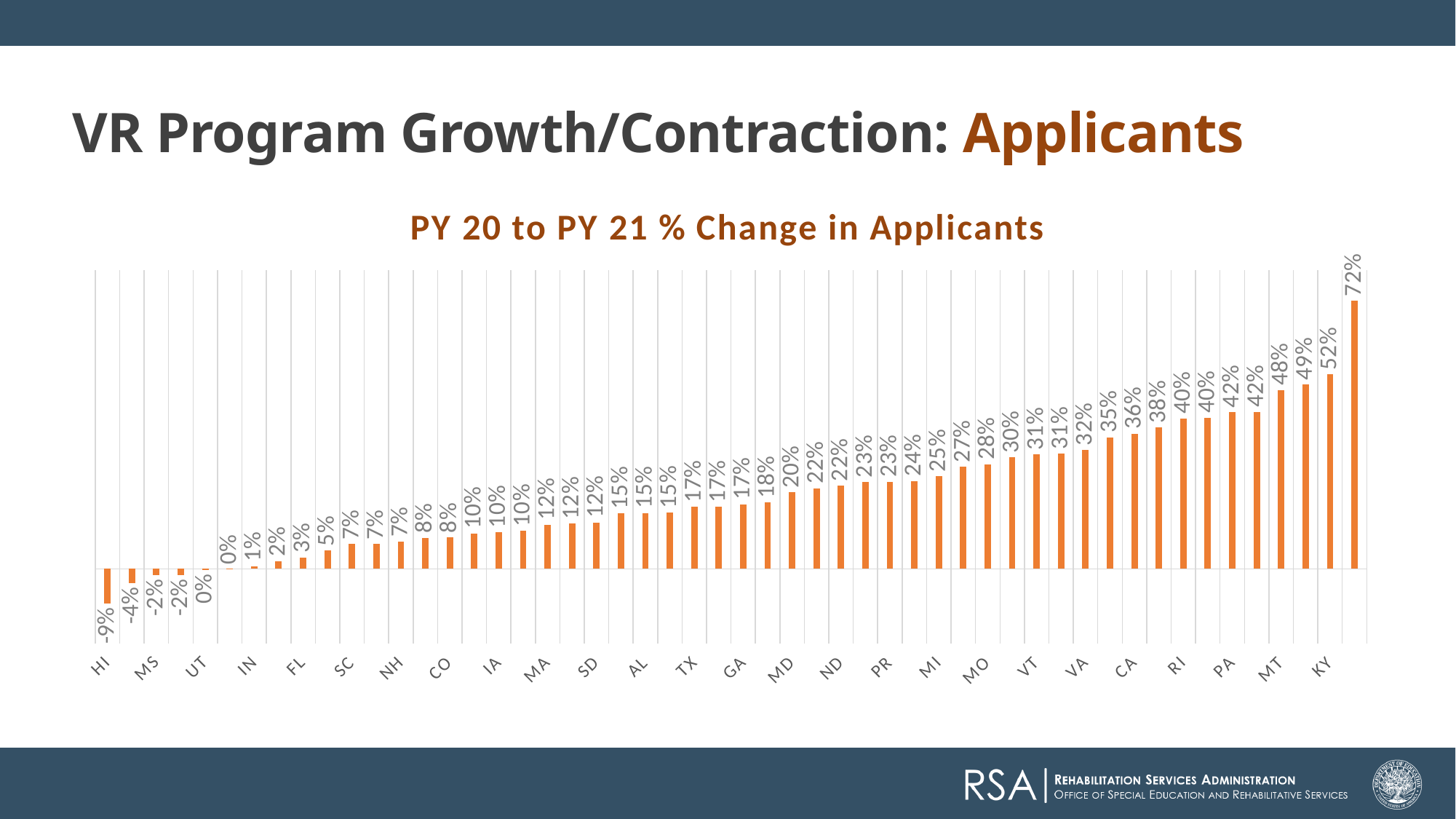
What is the PY 20 to PY 21 % change in applicants for VA? 32% Which has a larger % change in applicants, CA or MD? CA Which labeled state has the lowest % change in applicants? HI What is the highest % change value shown on the chart? 72% What is the PY 20 to PY 21 % change in applicants for KY? 52% Do the values rise or fall moving from left to right along the x axis? Rise What is the PY 20 to PY 21 % change in applicants for HI? -9% What is the title of the chart? PY 20 to PY 21 % Change in Applicants What is the PY 20 to PY 21 % change in applicants for CA? 36% What is the PY 20 to PY 21 % change in applicants for MD? 20% What is the difference in percentage points between the % change for KY and the % change for HI? 61 percentage points What kind of chart is shown on the slide? Bar chart